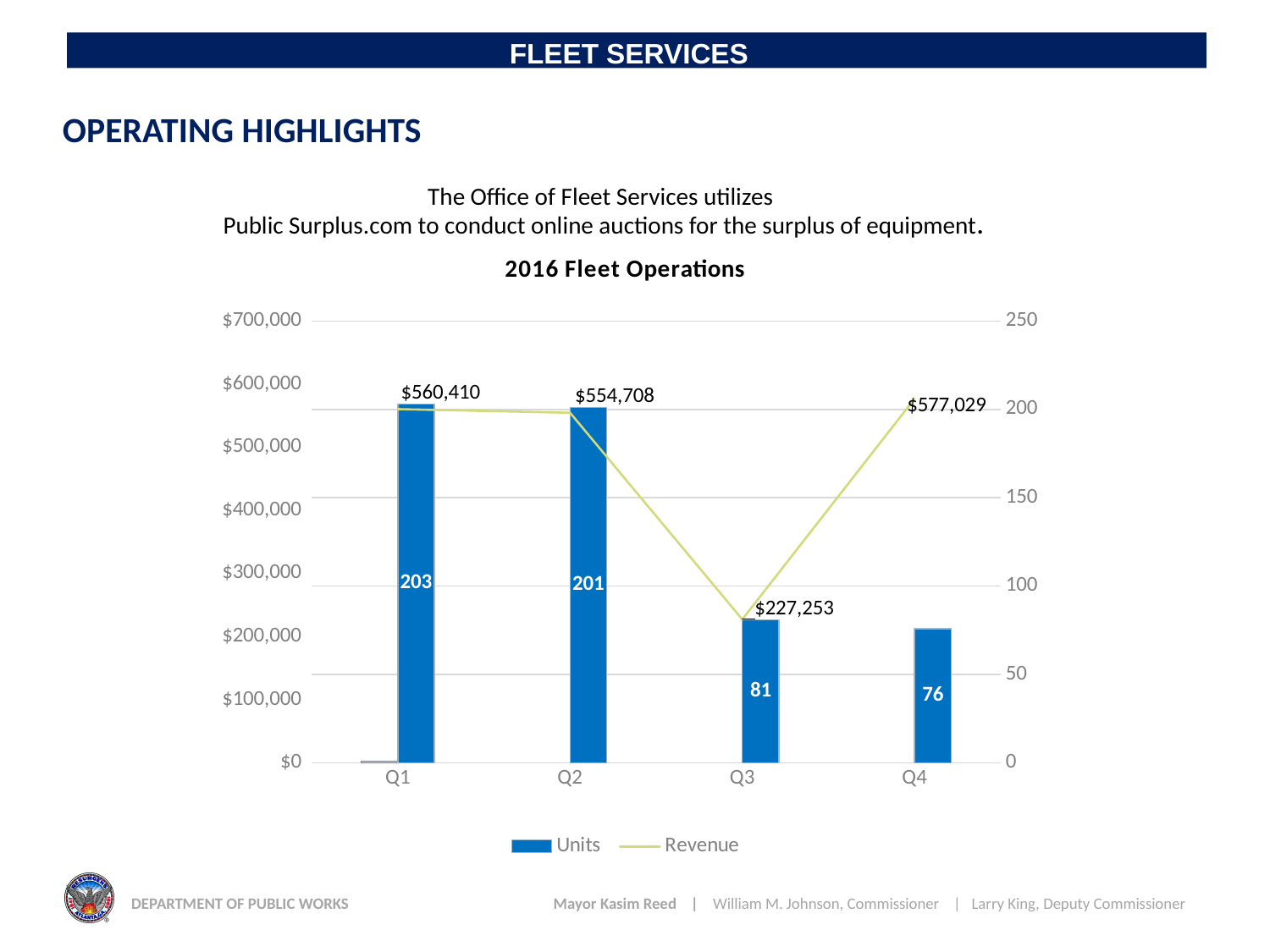
What is the Revenue value for Q4? $577,029 Which quarter has the lowest Units value? Q4 How many series does the chart legend list? 2 What is the Units value for Q1? 203 Which quarter has the highest Revenue value? Q4 What is the title of the chart? 2016 Fleet Operations Which is larger, the Revenue for Q1 or the Revenue for Q2? Q1 Which series is drawn as a line in the chart? Revenue What is the Revenue value for Q3? $227,253 How many quarters are shown on the x axis of the chart? 4 What is the difference in Units between Q1 and Q2? 2 Which quarter has the lowest Revenue value? Q3